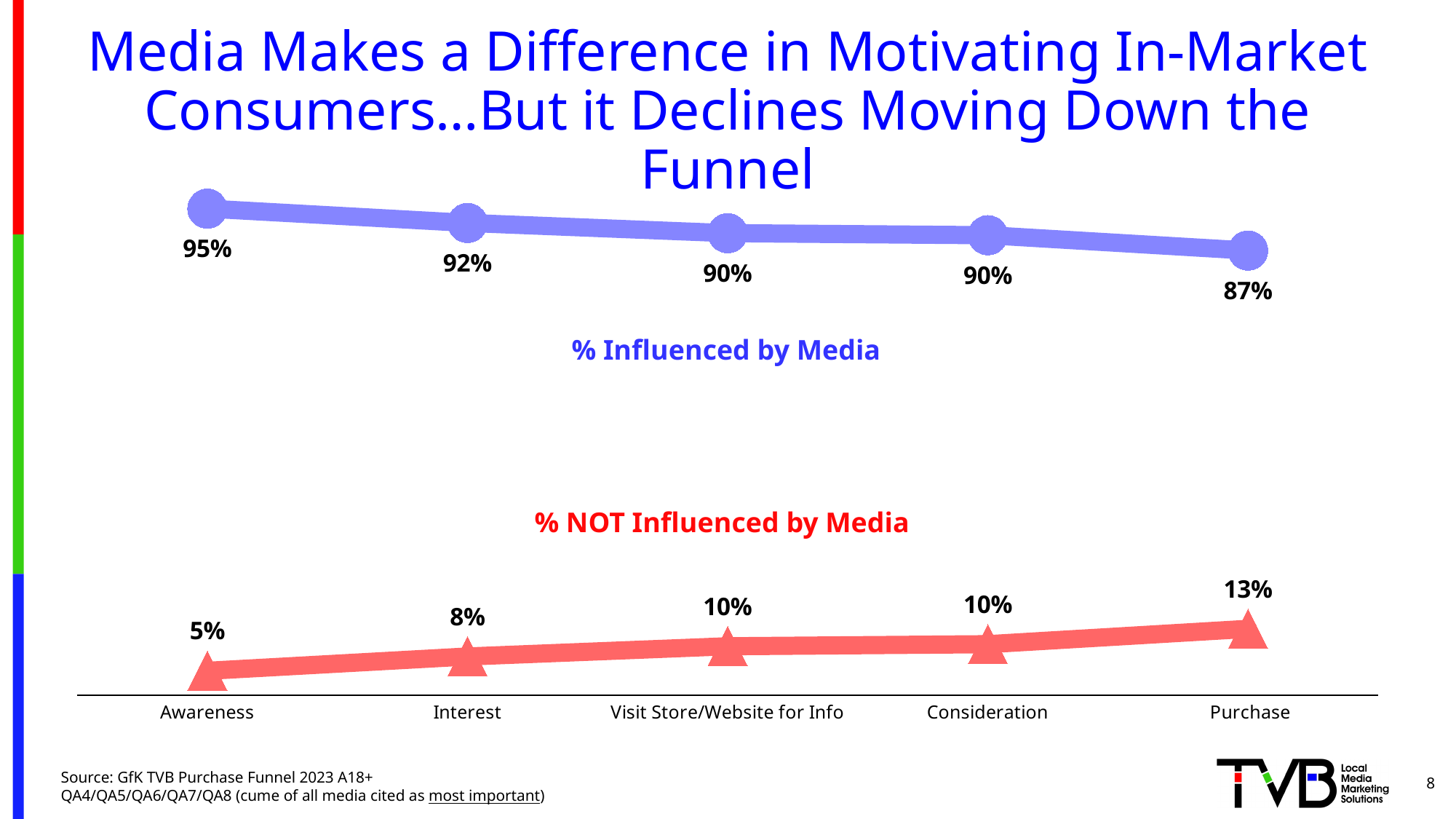
At which funnel stage is the % NOT Influenced by Media lowest? Awareness What is the difference between the % NOT Influenced by Media at Purchase and at Awareness? 8% What is the % NOT Influenced by Media value at the Purchase stage? 13% Does the % Influenced by Media rise or fall moving from Awareness to Purchase? fall What is the % Influenced by Media value at the Consideration stage? 90% What is the % NOT Influenced by Media value at the Interest stage? 8% At which funnel stage is the % Influenced by Media lowest? Purchase How many data series are plotted on the chart? 2 What is the difference between the % Influenced by Media at Awareness and at Purchase? 8% Which is larger: the % Influenced by Media at Interest or at Purchase? Interest How many funnel stages are shown on the x axis? 5 What is the % Influenced by Media value at the Awareness stage? 95%